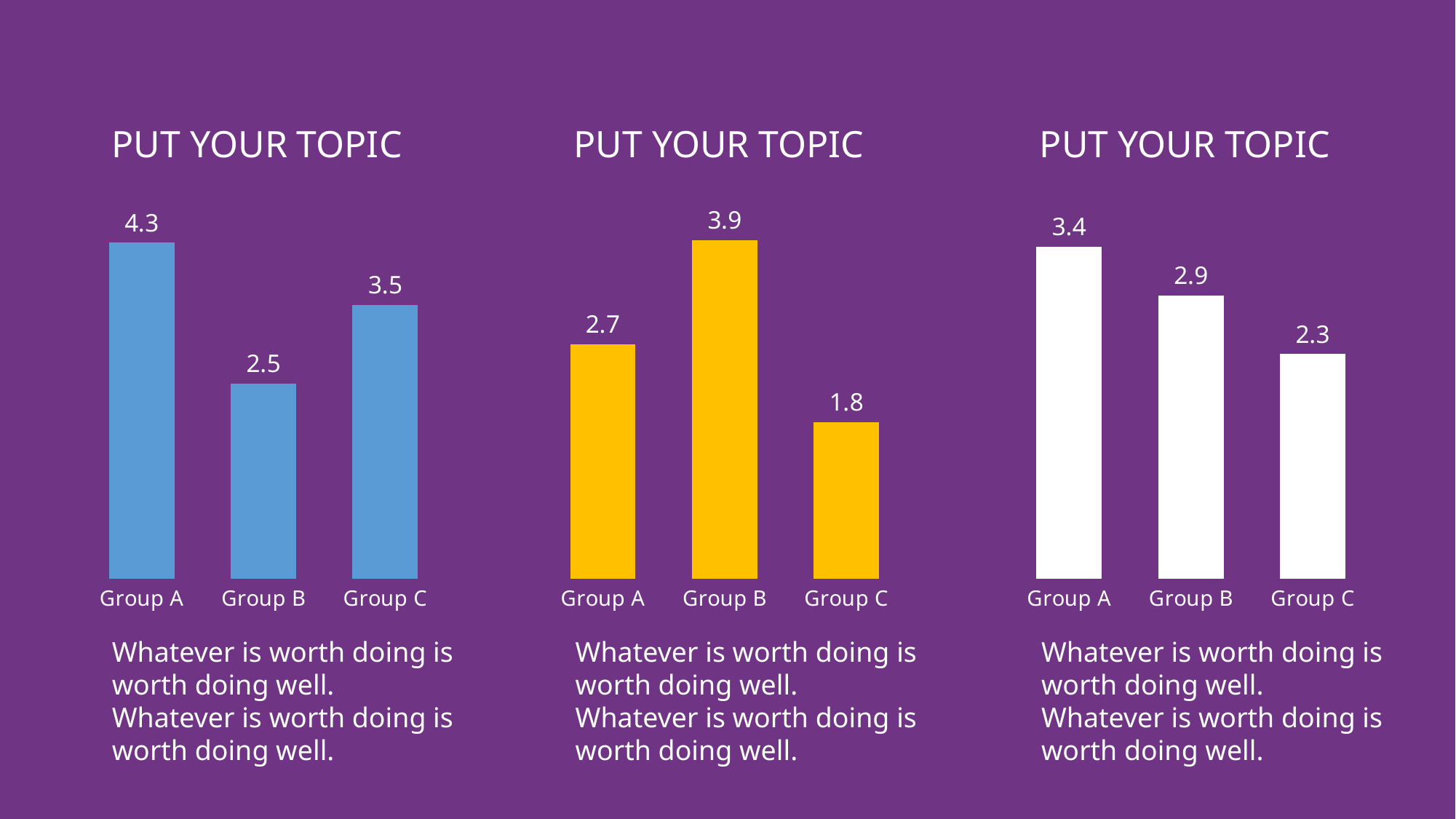
In the middle chart, which group has the highest value? Group B In the middle chart, what is the value for Group C? 1.8 In the right chart, what is the value for Group B? 2.9 In the left chart, what is the value for Group A? 4.3 How many bars does the middle chart have? 3 In the left chart, which group has the lowest value? Group B In the right chart, which is larger, the value for Group B or Group C? Group B What kind of chart is the left chart? Bar chart In the left chart, what is the difference between the values for Group A and Group C? 0.8 In the middle chart, what is the difference between the values for Group B and Group C? 2.1 In the right chart, which group has the highest value? Group A Do the values in the right chart rise or fall from Group A to Group C? Fall